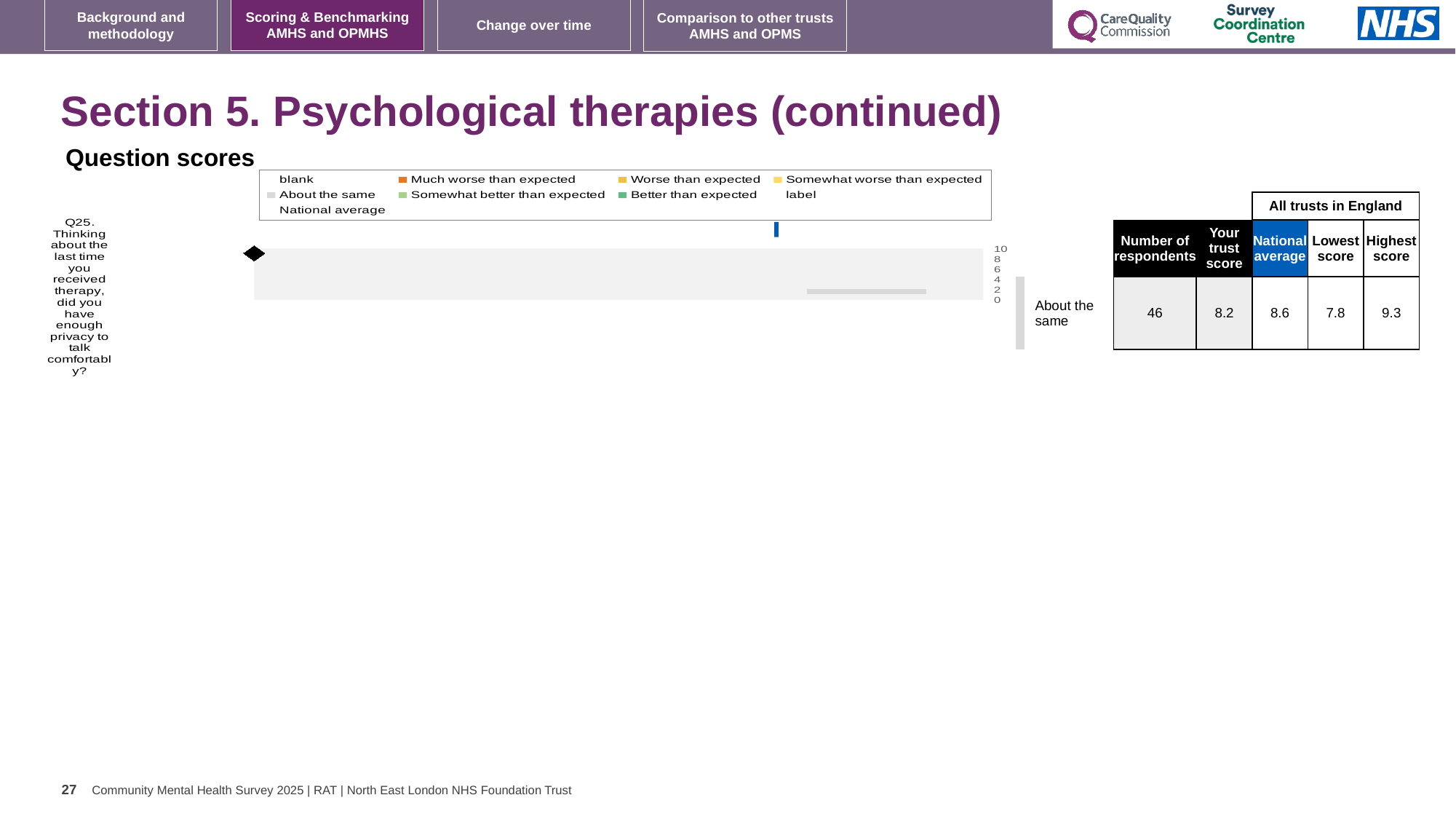
What is the difference between the national average and the trust score for Q25? 0.4 Which benchmark category is Q25 assigned to in the question scores chart? About the same What is the lowest score among all trusts in England for Q25? 7.8 What is the trust score for Q25 (privacy to talk comfortably during therapy)? 8.2 Which legend entry in the question scores chart is shown in orange? Much worse than expected What is the highest score among all trusts in England for Q25? 9.3 How many respondents answered Q25? 46 What kind of chart is used to show the Q25 question score? bar chart What is the national average score for Q25? 8.6 How many survey questions are plotted in the question scores chart? 1 What is the difference between the highest and lowest scores for Q25 across all trusts in England? 1.5 Which is larger for Q25, the trust score or the national average? national average